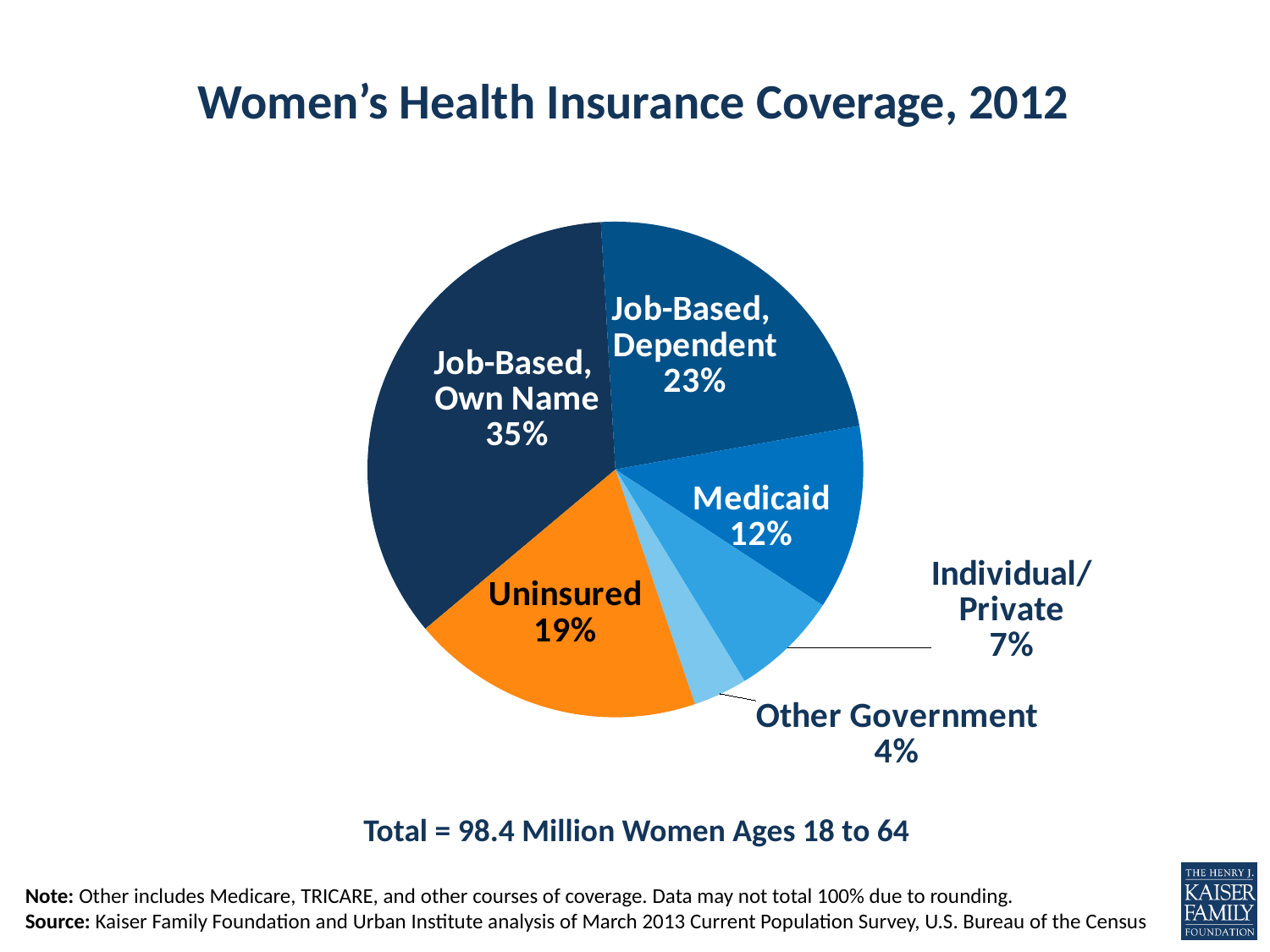
What type of chart is shown on the slide? Pie chart Which coverage category has the smallest slice of the pie? Other Government Which coverage category has the largest slice of the pie? Job-Based, Own Name What percentage is shown for Other Government? 4% What is the title of the chart? Women's Health Insurance Coverage, 2012 What percentage of women are Uninsured according to the pie chart? 19% What share of women's health insurance coverage is Job-Based, Own Name? 35% What share of coverage is Medicaid? 12% Which is larger, the Medicaid slice or the Uninsured slice? Uninsured What is the difference in percentage points between Uninsured and Individual/Private? 12 How many categories are shown in the pie chart? 6 How many percentage points larger is Job-Based, Own Name than Job-Based, Dependent? 12